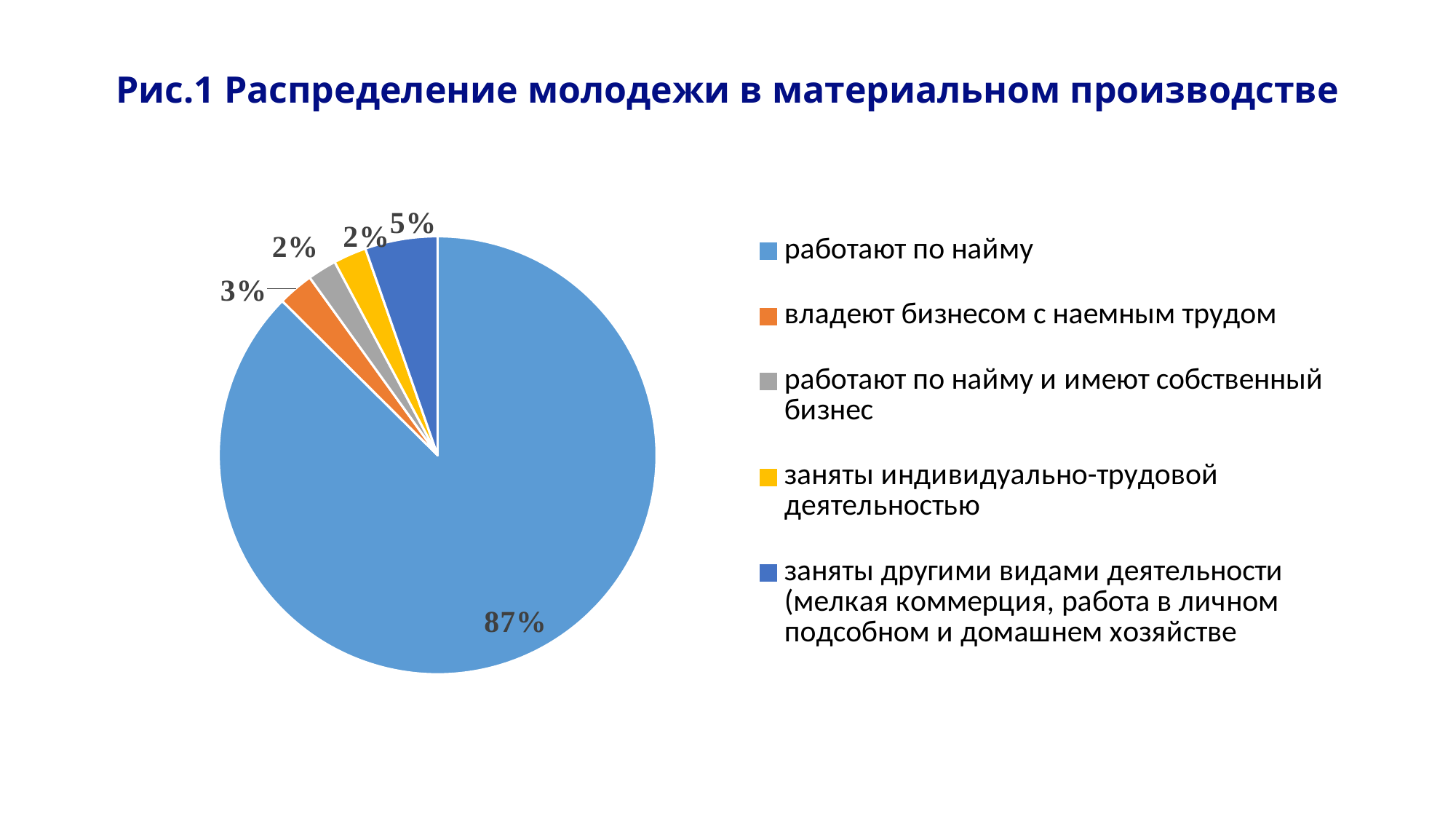
What is the difference in percentage points between "работают по найму" and "заняты другими видами деятельности"? 82 What percentage is shown for "работают по найму и имеют собственный бизнес"? 2% Which is larger: the slice for "владеют бизнесом с наемным трудом" or the slice for "заняты другими видами деятельности"? заняты другими видами деятельности What type of chart is shown on the slide? pie chart Which category has the largest slice of the pie? работают по найму What percentage is shown for "заняты другими видами деятельности (мелкая коммерция, работа в личном подсобном и домашнем хозяйстве"? 5% How many slices does the pie chart have? 5 What percentage is shown for "владеют бизнесом с наемным трудом"? 3% What is the title of the chart on the slide? Рис.1 Распределение молодежи в материальном производстве What percentage is shown for "заняты индивидуально-трудовой деятельностью"? 2% What share of the pie is labelled for "работают по найму"? 87% What is the difference in percentage points between "заняты другими видами деятельности" and "владеют бизнесом с наемным трудом"? 2